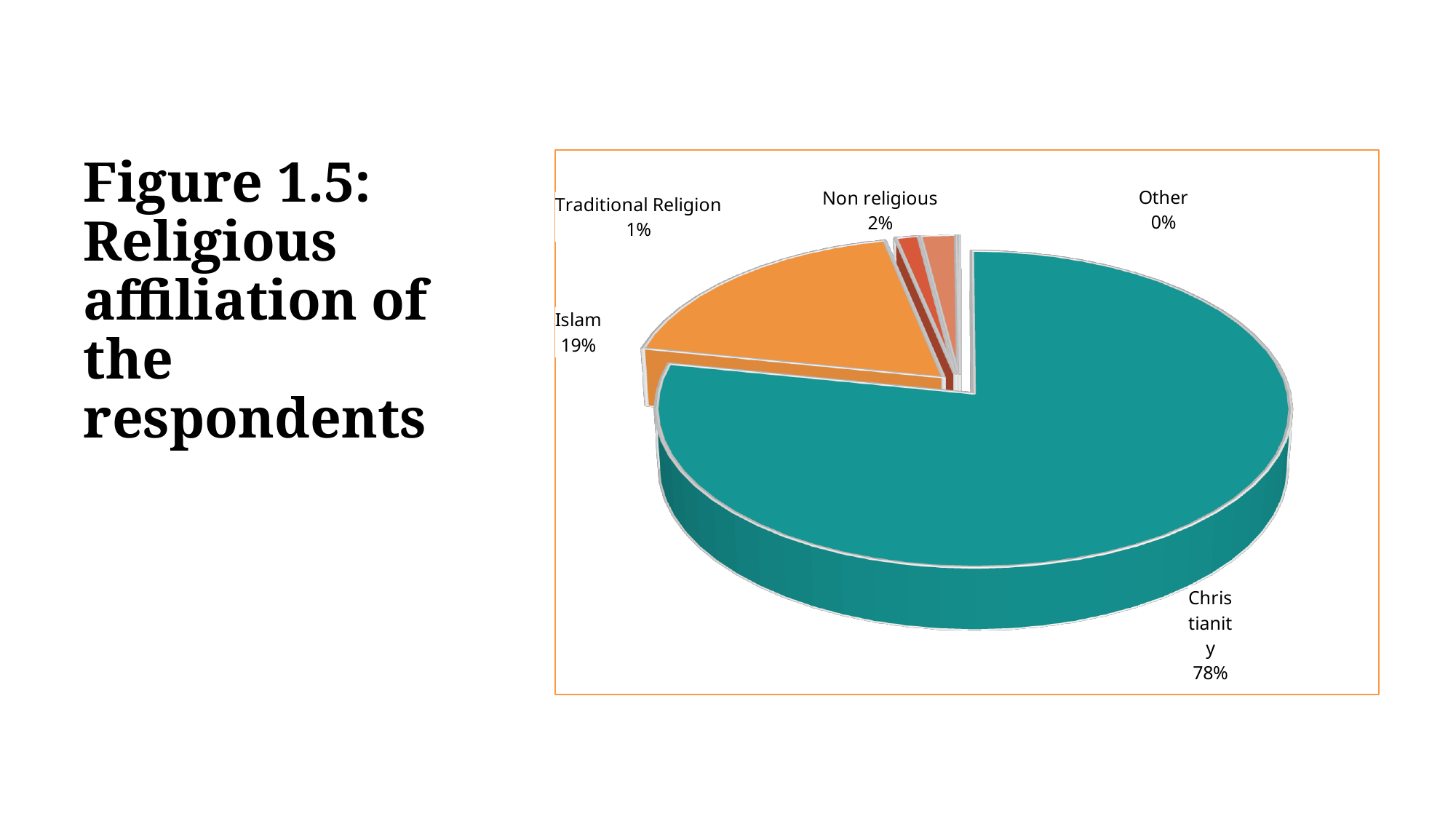
How many religious affiliation categories are shown in the pie chart? 5 Which religious affiliation has the smallest share of respondents? Other What share of respondents are Non religious? 2% What is the title of the figure on the slide? Figure 1.5: Religious affiliation of the respondents Which has a larger share, Islam or Non religious? Islam What is the difference in percentage points between Christianity and Islam? 59 What share of respondents are affiliated with Islam? 19% What share of respondents follow Traditional Religion? 1% What kind of chart is shown on the slide? Pie chart What share of respondents fall under Other? 0% What share of respondents are affiliated with Christianity? 78% Which religious affiliation has the largest share of respondents? Christianity